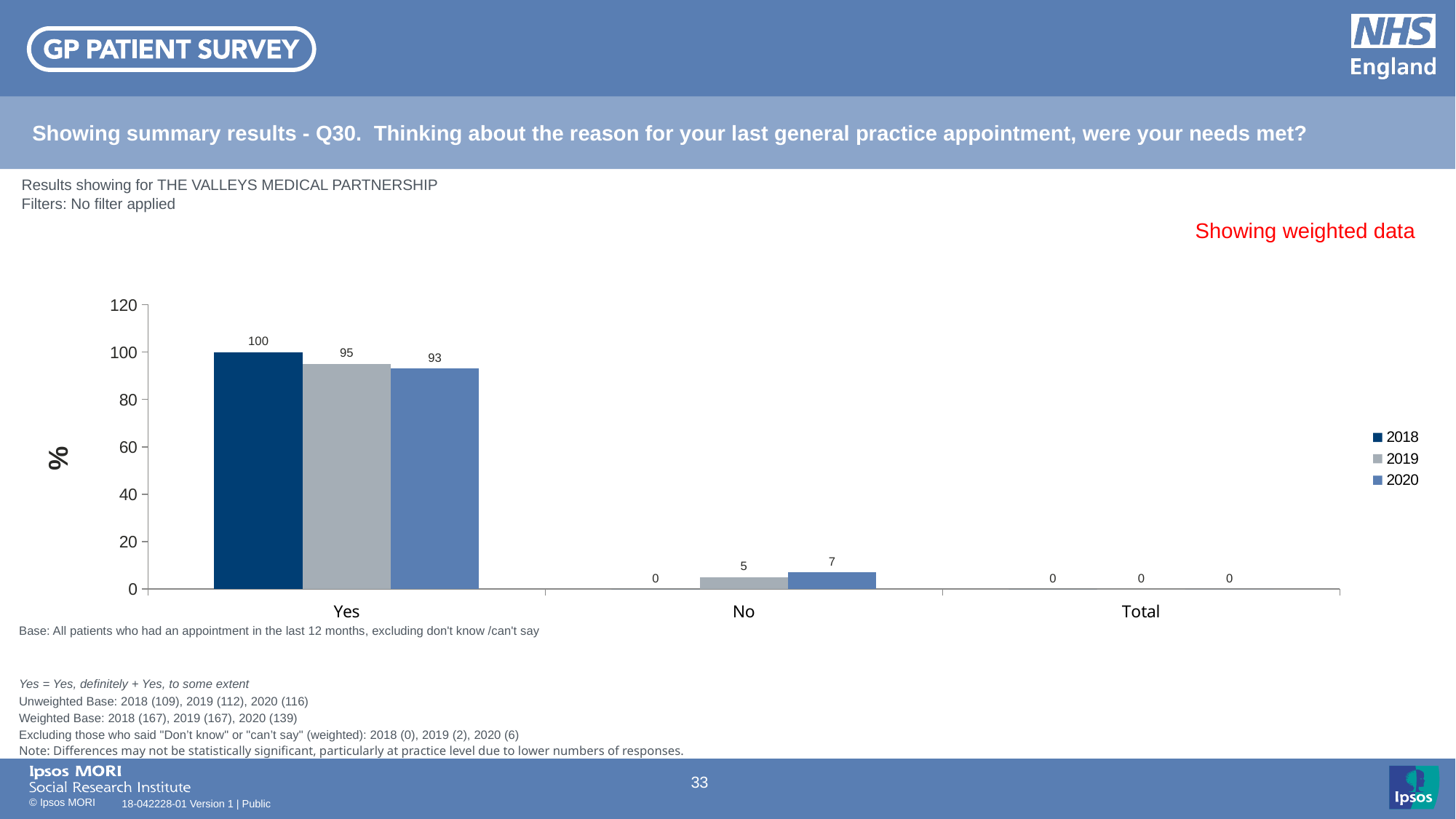
What is the value for 2018 in the Yes category? 100 What is the value for 2019 in the No category? 5 Which year has the highest value in the Yes category? 2018 What is the value for 2020 in the No category? 7 How many series does the legend list? 3 What kind of chart is shown on the slide? Bar chart Which year has the lowest value in the Yes category? 2020 What is the value for 2019 in the Yes category? 95 What is the difference between the 2018 and 2020 values in the Yes category? 7 What is the label on the y axis? % How many categories are shown on the x axis? 3 Which is larger in the No category, the value for 2019 or the value for 2020? 2020